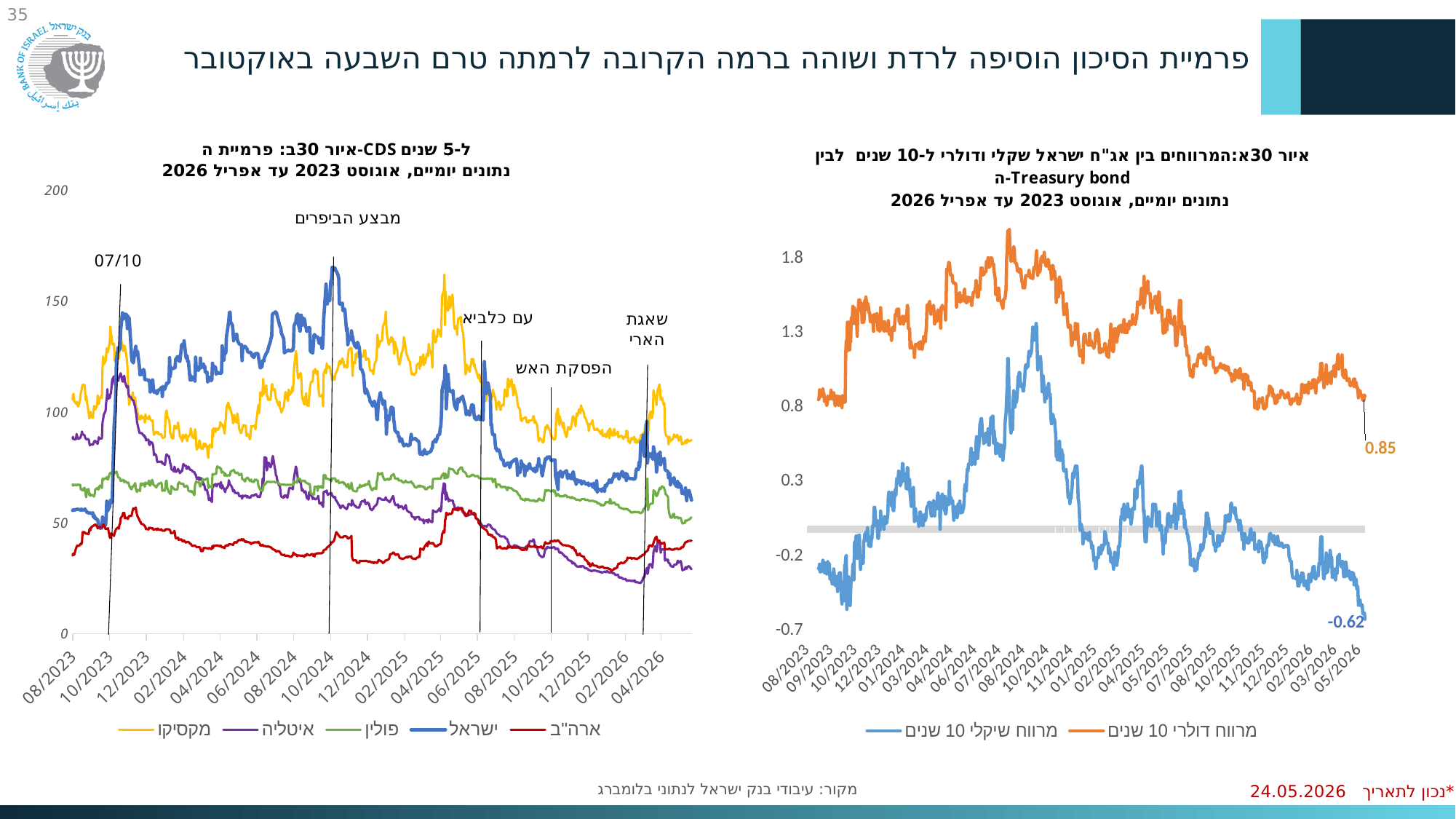
On the left chart (איור 30ב), is the peak value of the Israel (ישראל) line around 10/2024 greater or less than 150? greater On the right chart (איור 30א), what is the final value shown for the shekel 10-year spread (מרווח שיקלי 10 שנים)? -0.62 On the right chart (איור 30א), what is the final value shown for the dollar 10-year spread (מרווח דולרי 10 שנים)? 0.85 On the right chart (איור 30א), what is the difference between the final labelled values of the dollar spread (0.85) and the shekel spread (-0.62)? 1.47 On the right chart (איור 30א), how many series does the legend list? 2 On the left chart (איור 30ב), is the value for Italy (איטליה) at the end of the period (04/2026) greater or less than 50? less What kind of chart is the left chart (איור 30ב)? Line chart On the left chart (איור 30ב), how many countries does the legend list? 5 On the left chart (איור 30ב), which event annotation is marked at the vertical line near 10/2024? מבצע הביפרים On the right chart (איור 30א), does the shekel spread (מרווח שיקלי 10 שנים) rise or fall between 05/2025 and 05/2026? fall On the right chart (איור 30א), is the shekel spread (מרווח שיקלי 10 שנים) at the start of the period (08/2023) greater or less than 0? less On the right chart (איור 30א), which series has the higher final labelled value, the dollar spread or the shekel spread? מרווח דולרי 10 שנים (dollar spread)